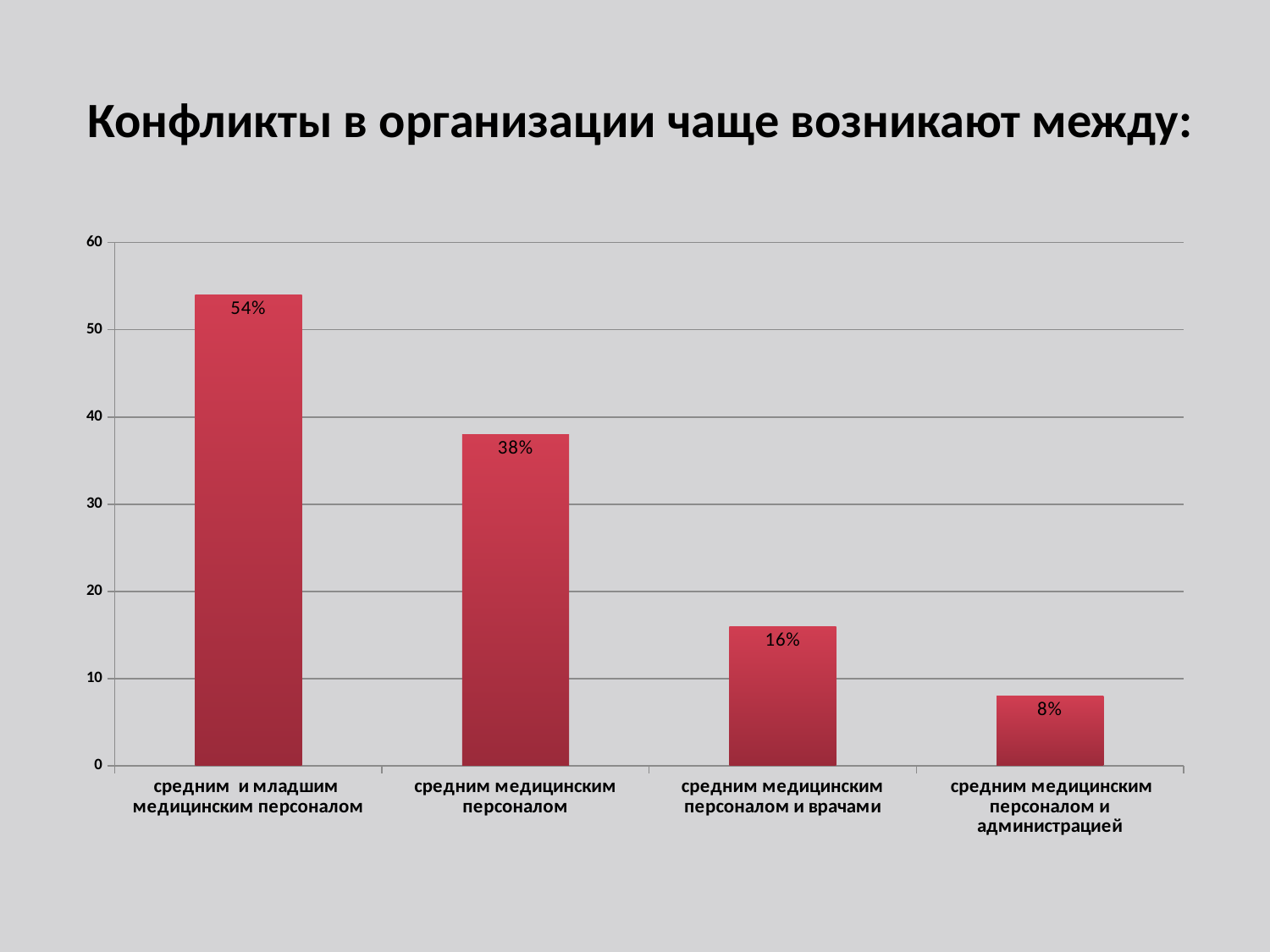
Which category has the lowest value? средним медицинским персоналом и администрацией What is the title of the slide? Конфликты в организации чаще возникают между: Is the value for 'средним медицинским персоналом' greater or less than 40? less What is the value for 'средним медицинским персоналом'? 38% What is the value for 'средним медицинским персоналом и врачами'? 16% What is the value for 'средним медицинским персоналом и администрацией'? 8% Which category has the highest value? средним и младшим медицинским персоналом How many categories are shown in the chart? 4 What is the value for 'средним и младшим медицинским персоналом'? 54% What is the difference between the values for 'средним и младшим медицинским персоналом' and 'средним медицинским персоналом'? 16% What kind of chart is shown on the slide? bar chart Which is larger: the value for 'средним медицинским персоналом и врачами' or for 'средним медицинским персоналом и администрацией'? средним медицинским персоналом и врачами